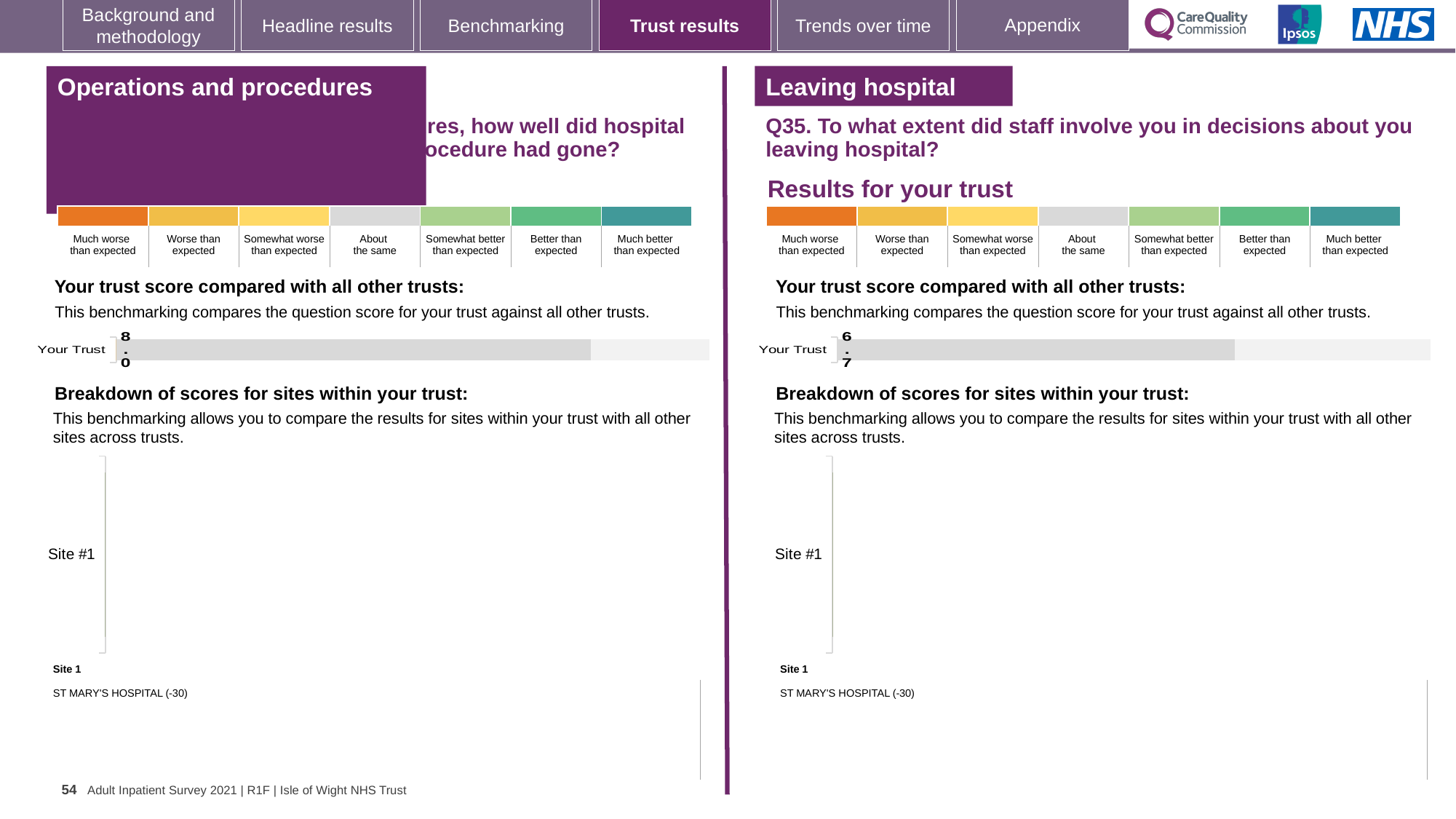
Which site is listed as Site 1 in the breakdown of scores on the right-hand 'Leaving hospital' section? ST MARY'S HOSPITAL (-30) Which question number is shown for the 'Leaving hospital' section on the right? Q35 How many categories does the colour scale above each chart list, from 'Much worse than expected' to 'Much better than expected'? 7 What kind of chart is used to show the Your Trust score on the left-hand side of the slide? Bar chart What kind of chart is used to show the Your Trust score on the right-hand 'Leaving hospital' section? Bar chart What is the difference between the Your Trust score on the left chart (8.0) and the Your Trust score on the right chart (6.7)? 1.3 How many categories are plotted in the 'Your trust score compared with all other trusts' chart on the right-hand side? 1 On the left-hand 'Operations and procedures' chart, what is the score shown for Your Trust? 8.0 Which section's Your Trust score is higher: 'Operations and procedures' on the left or 'Leaving hospital' on the right? Operations and procedures What is the label of the single category in the Your Trust chart on the left-hand side? Your Trust On the right-hand 'Leaving hospital' chart for Q35, what is the score shown for Your Trust? 6.7